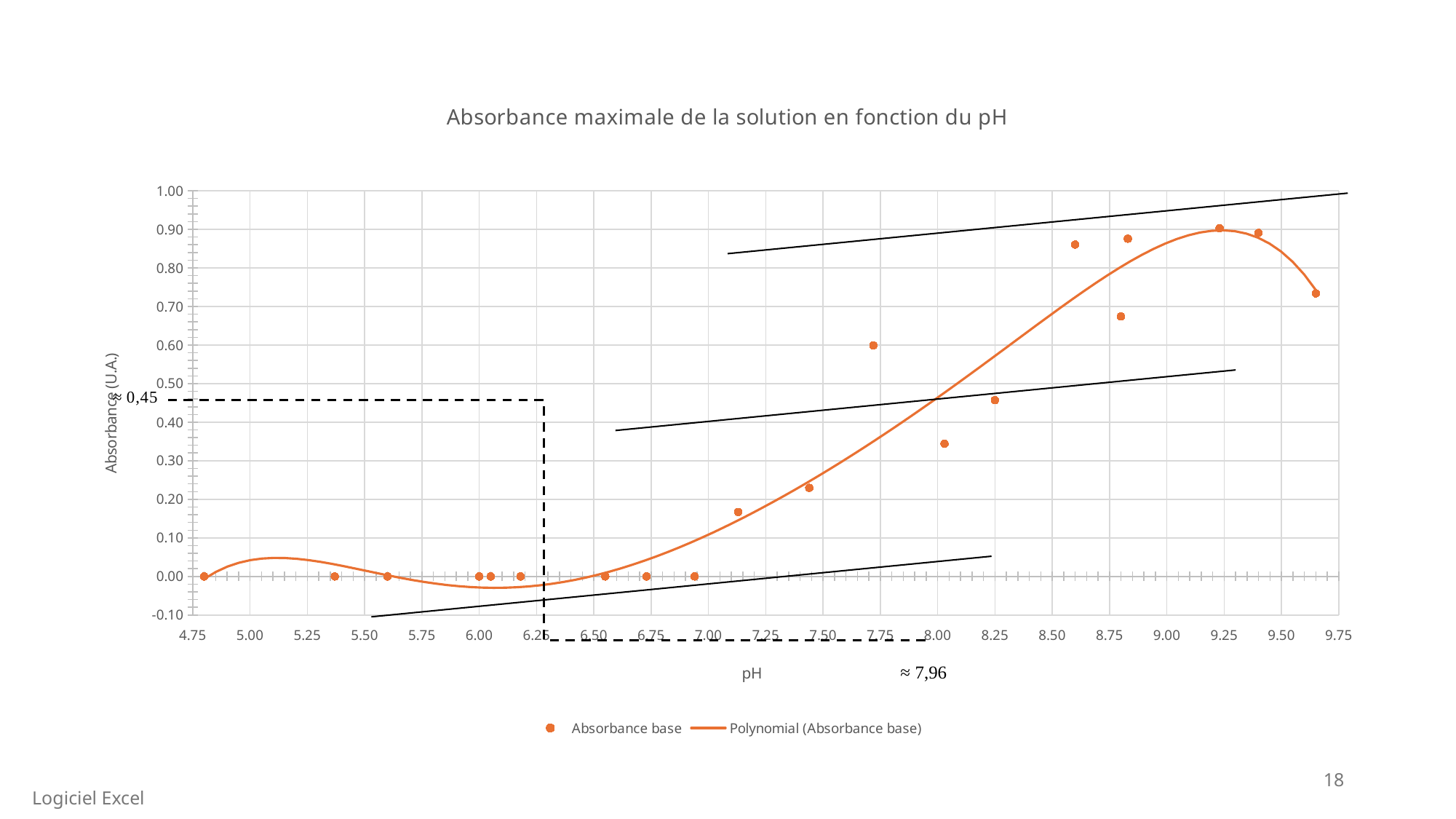
Is the absorbance value for the data point near pH 8.60 greater or less than 0.80? greater Is the absorbance value for the data point near pH 8.00 greater or less than 0.40? less Is the absorbance value for the data point near pH 7.10 greater or less than 0.10? greater What label is shown on the vertical axis? Absorbance (U.A.) Which data point has the larger absorbance: the one near pH 8.60 or the one near pH 9.65? the one near pH 8.60 How many series does the legend list? 2 What is the title of the chart? Absorbance maximale de la solution en fonction du pH Which data point has the larger absorbance: the one near pH 7.75 or the one near pH 8.00? the one near pH 7.75 Overall, do the absorbance values rise or fall as pH increases from 6.50 to 9.25? rise What kind of chart is shown on the slide? scatter chart